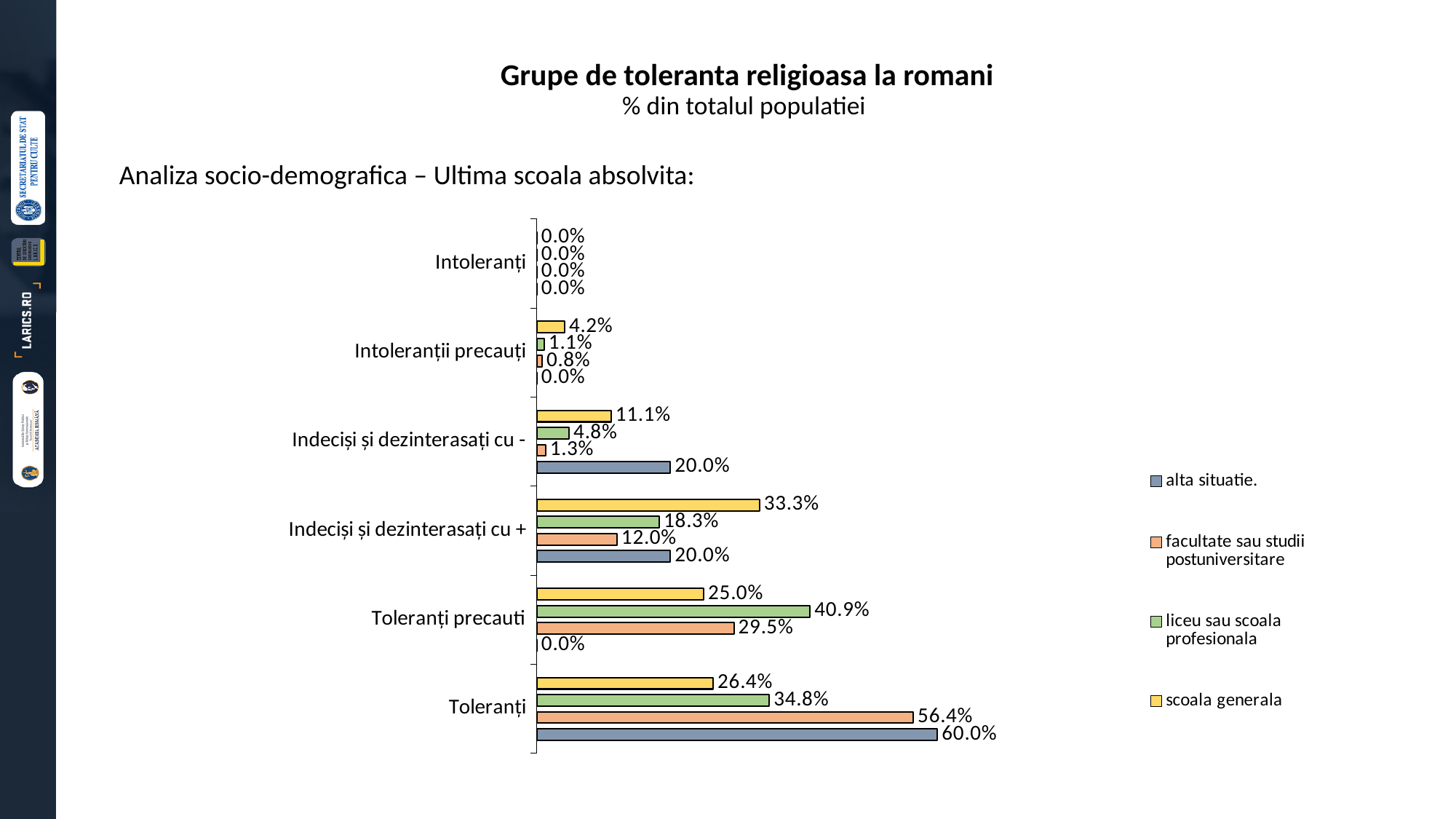
Which series has the lowest value in the 'Toleranți precauti' category? alta situatie. In the 'Indeciși și dezinterasați cu +' category, which is larger: 'scoala generala' or 'liceu sau scoala profesionala'? scoala generala What is the value for 'liceu sau scoala profesionala' in the 'Toleranți precauti' category? 40.9% How many categories are shown on the chart? 6 Which series has the highest value in the 'Toleranți' category? alta situatie. What is the value for 'scoala generala' in the 'Toleranți' category? 26.4% How many series does the legend list? 4 What is the value for 'alta situatie.' in the 'Indeciși și dezinterasați cu +' category? 20.0% What kind of chart is shown on the slide? bar chart What is the value for 'facultate sau studii postuniversitare' in the 'Toleranți' category? 56.4% What is the title of the chart? Grupe de toleranta religioasa la romani What is the difference between the 'alta situatie.' and 'scoala generala' values in the 'Toleranți' category? 33.6%